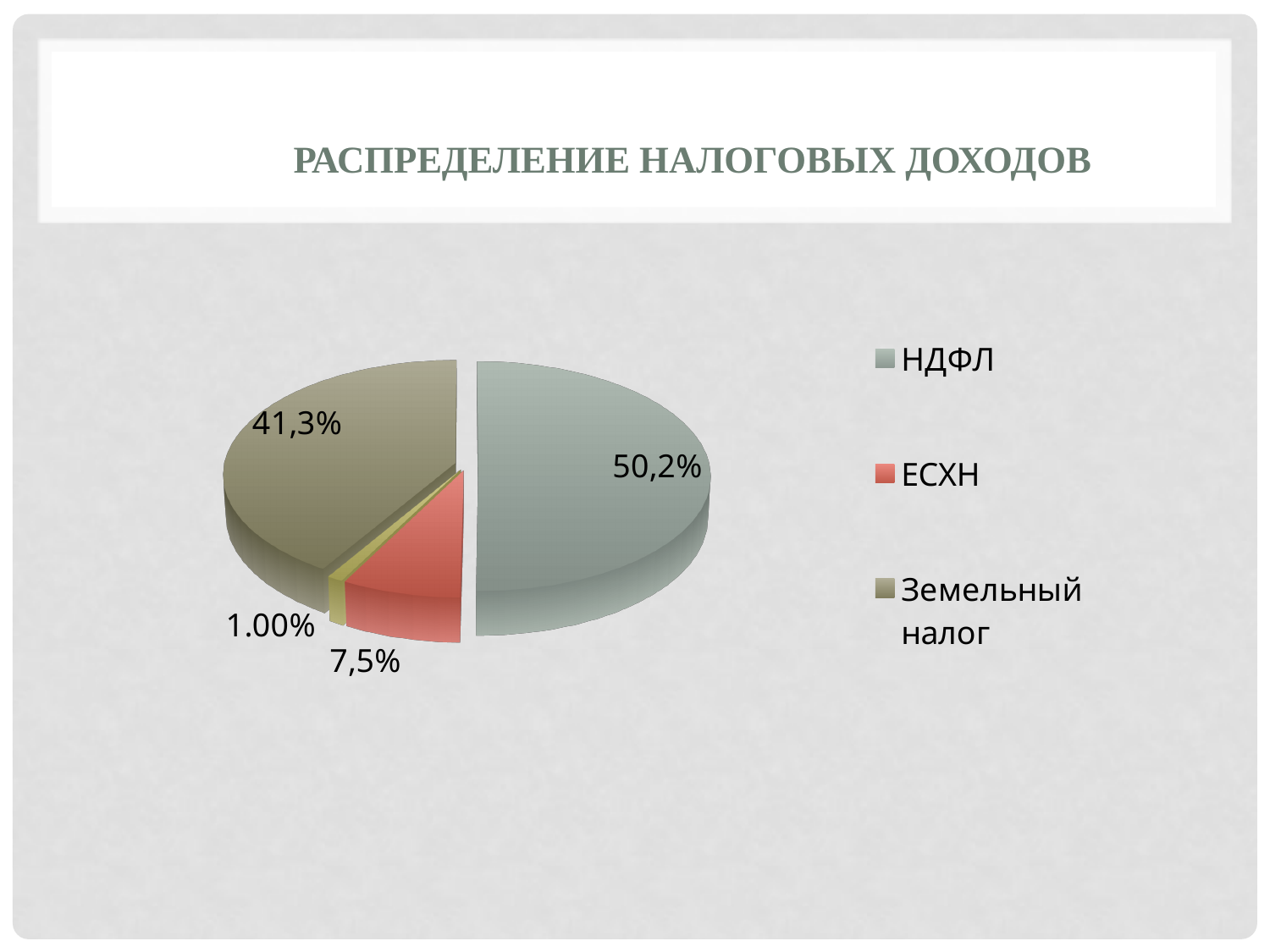
What percentage is shown for Земельный налог? 41,3% What is the title of the slide? РАСПРЕДЕЛЕНИЕ НАЛОГОВЫХ ДОХОДОВ How many slices does the pie chart have? 4 What share of tax revenues does НДФЛ account for in the pie chart? 50,2% What is the difference between the Земельный налог share and the ЕСХН share? 33,8% What percentage is shown for ЕСХН? 7,5% How many entries does the legend list? 3 By how many percentage points does the НДФЛ slice exceed the Земельный налог slice? 8,9% What is the smallest percentage labelled on the pie chart? 1.00% What type of chart is shown on the slide? Pie chart Which legend category has the largest slice of the pie? НДФЛ Which is larger, the share for НДФЛ or the share for Земельный налог? НДФЛ